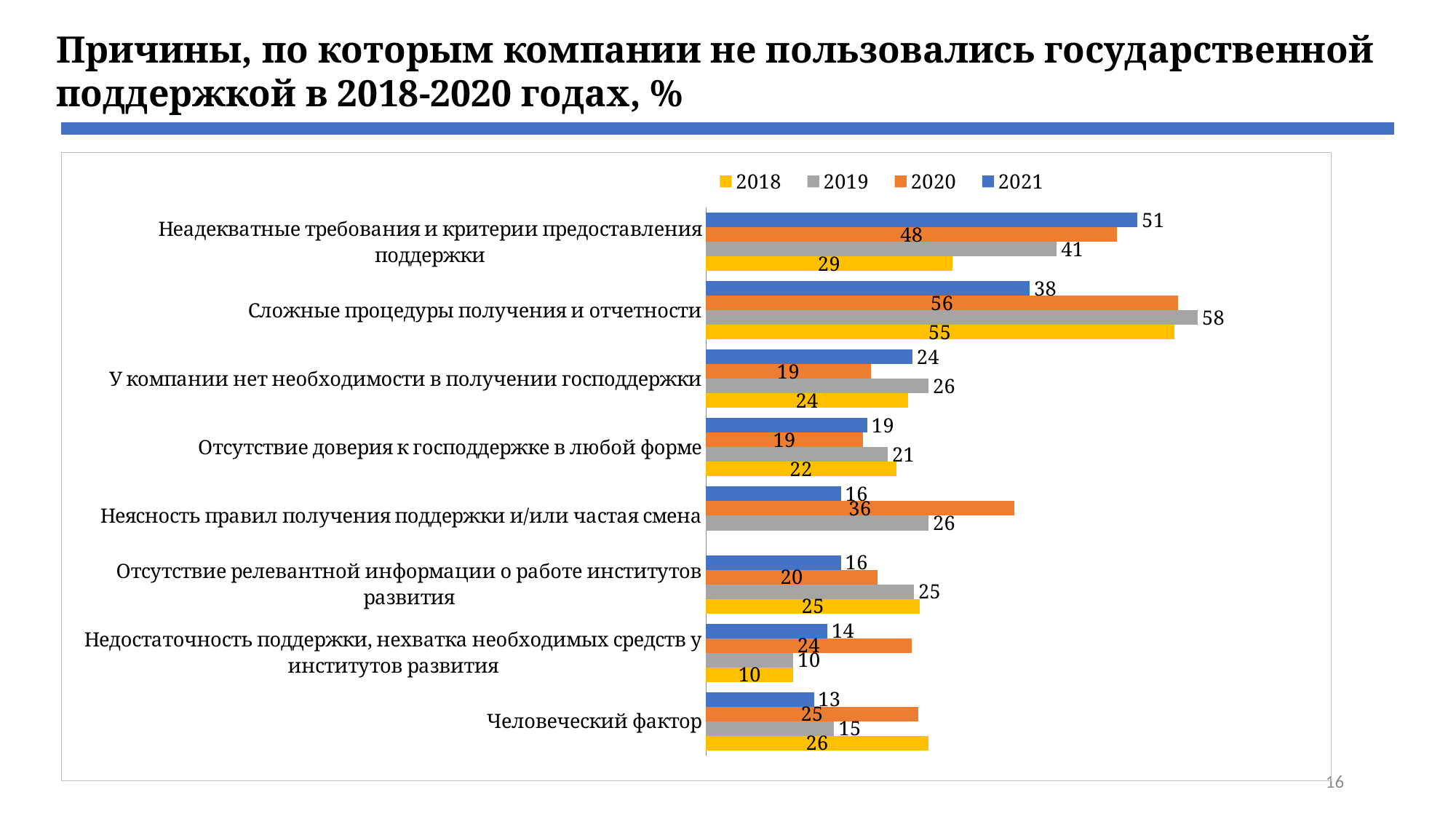
How many reason categories are shown on the chart? 8 What is the difference between the 2021 and 2018 values for "Неадекватные требования и критерии предоставления поддержки"? 22 Which legend entry is shown in yellow? 2018 Which category has the highest 2021 value? Неадекватные требования и критерии предоставления поддержки What type of chart is shown on the slide? bar chart For "Сложные процедуры получения и отчетности", which is larger: the 2020 value or the 2021 value? 2020 What is the 2020 value for "Неясность правил получения поддержки и/или частая смена"? 36 What is the 2021 value for "Неадекватные требования и критерии предоставления поддержки"? 51 What is the 2019 value for "Сложные процедуры получения и отчетности"? 58 Which category has the lowest 2021 value? Человеческий фактор What is the 2018 value for "Человеческий фактор"? 26 How many series does the legend list? 4